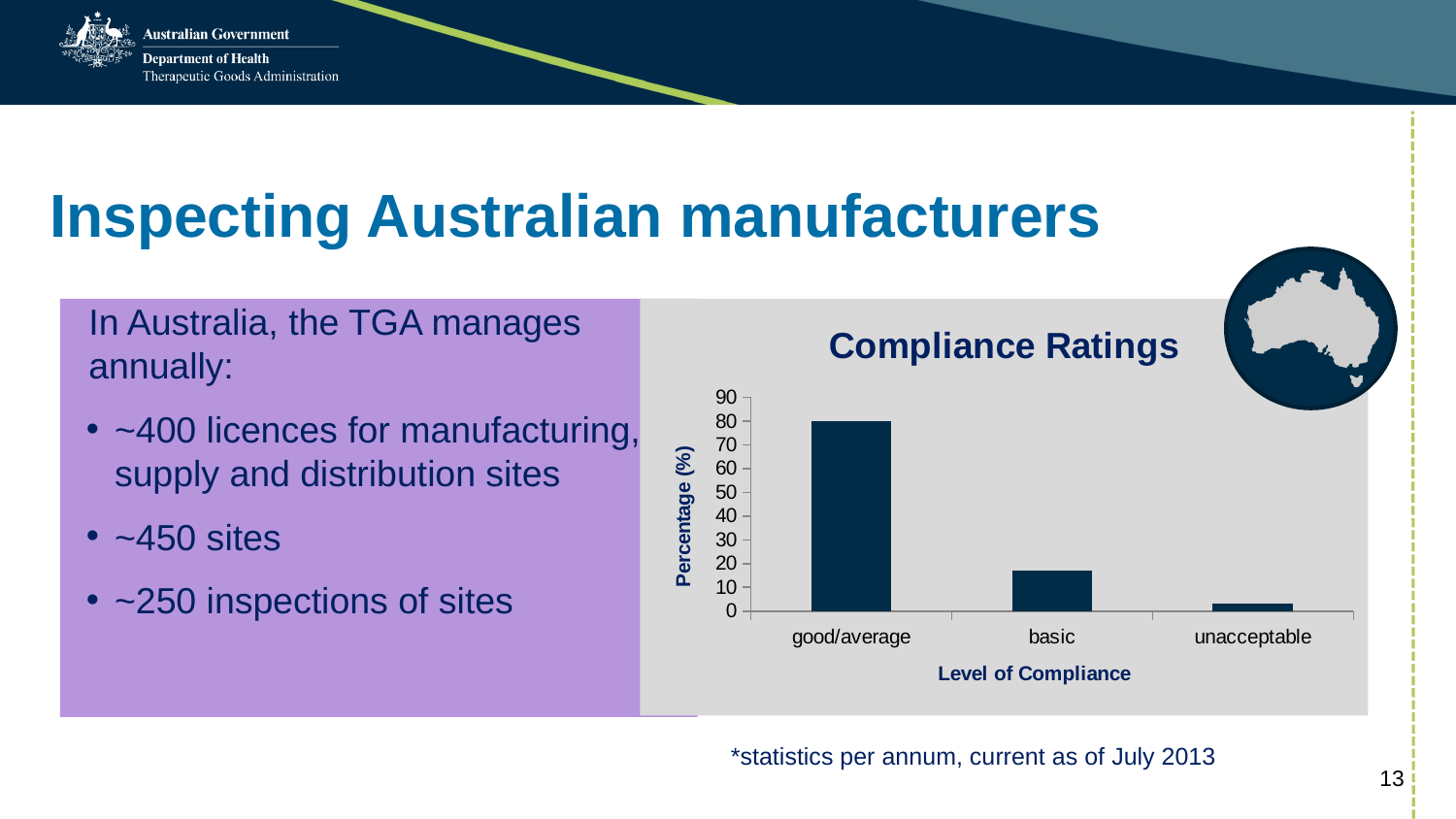
Which has a higher percentage, basic or unacceptable? basic How many categories are shown on the x axis of the chart? 3 Is the value for unacceptable greater or less than 10? less Is the value for basic greater or less than 20? less What is the title of the chart? Compliance Ratings What is the label of the x axis of the chart? Level of Compliance What kind of chart is shown on the slide? bar chart Is the value for basic greater or less than 10? greater Which level of compliance has the lowest percentage? unacceptable Do the values rise or fall moving from left to right along the x axis? fall Which level of compliance has the highest percentage? good/average